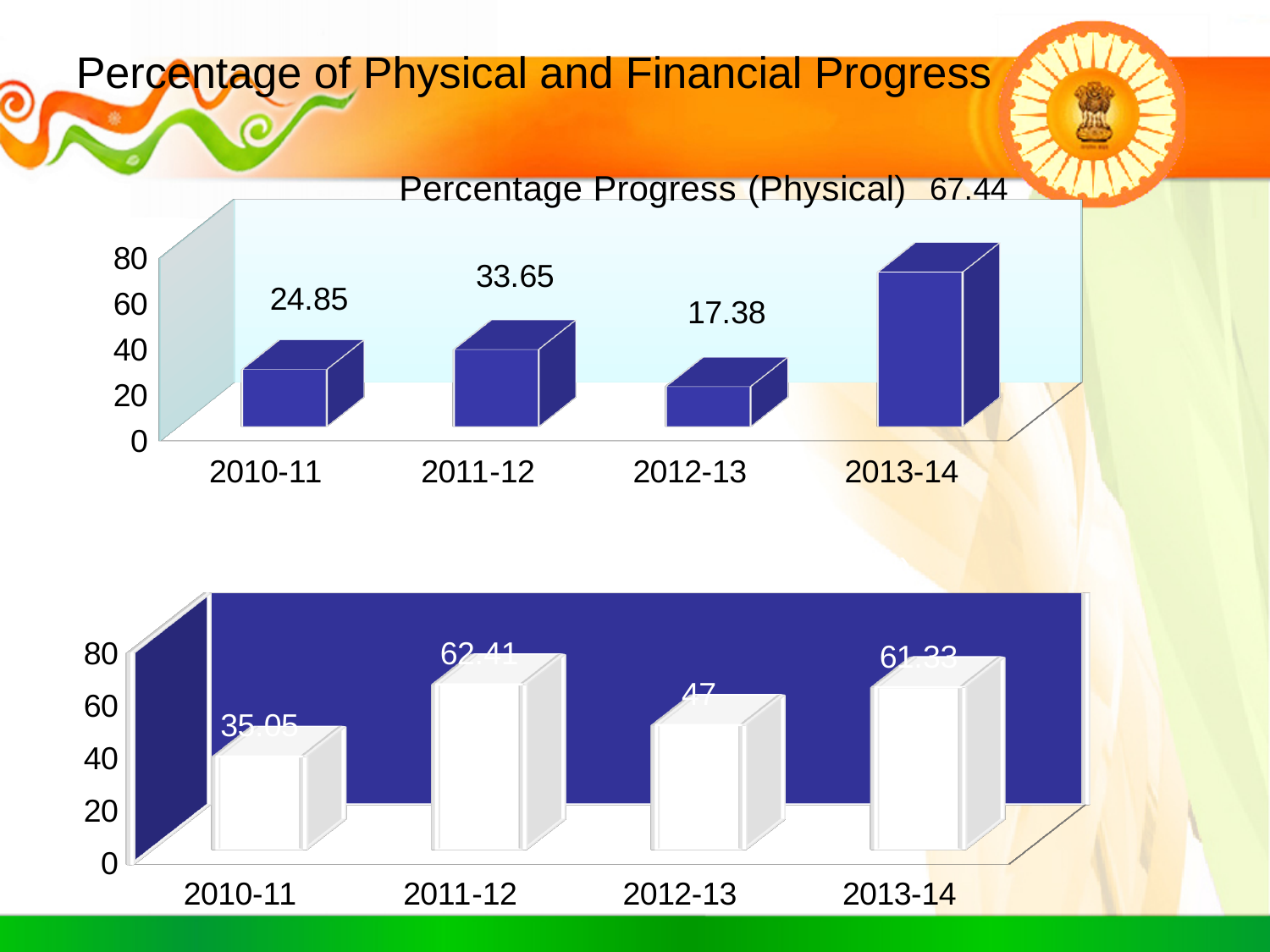
In the bottom chart, what is the value for 2010-11? 35.05 In the bottom chart, which year has the lowest value? 2010-11 In the Percentage Progress (Physical) chart, which year has the highest value? 2013-14 How many years are shown in the Percentage Progress (Physical) chart? 4 In the Percentage Progress (Physical) chart, which year has the lowest value? 2012-13 In the Percentage Progress (Physical) chart, what is the value for 2012-13? 17.38 In the bottom chart, what is the value for 2012-13? 47 What type of chart is the Percentage Progress (Physical) chart? bar chart In the Percentage Progress (Physical) chart, is the value for 2013-14 greater or less than 60? greater In the Percentage Progress (Physical) chart, what is the difference between the values for 2011-12 and 2010-11? 8.80 In the bottom chart, which is larger, the value for 2011-12 or the value for 2012-13? 2011-12 In the Percentage Progress (Physical) chart, what is the value for 2013-14? 67.44